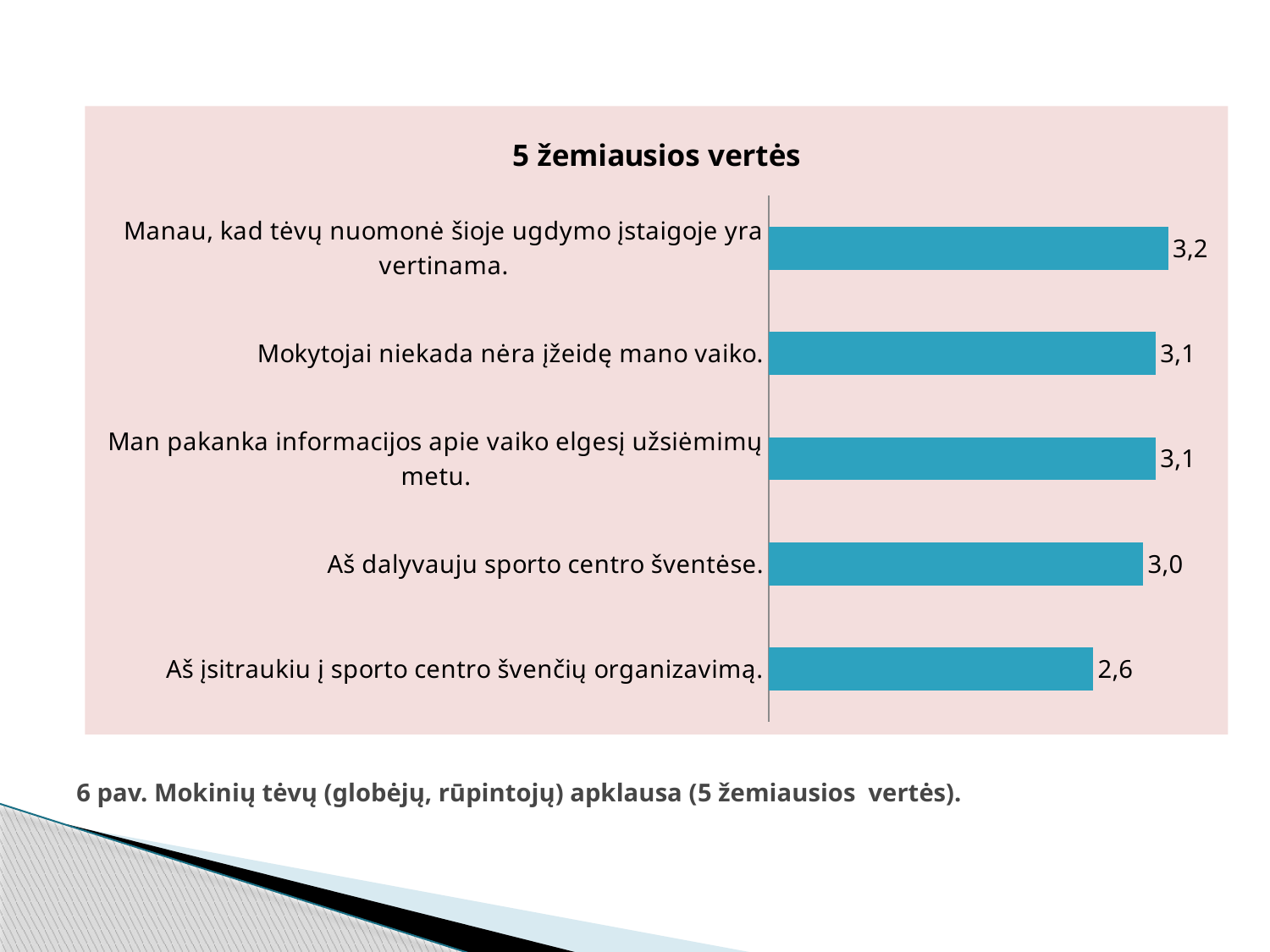
What is the value for "Aš dalyvauju sporto centro šventėse."? 3,0 Which category has the highest value? Manau, kad tėvų nuomonė šioje ugdymo įstaigoje yra vertinama. How many categories are shown in the chart? 5 Which category has the lowest value? Aš įsitraukiu į sporto centro švenčių organizavimą. What is the value for "Manau, kad tėvų nuomonė šioje ugdymo įstaigoje yra vertinama."? 3,2 What is the title of the chart? 5 žemiausios vertės What is the value for "Aš įsitraukiu į sporto centro švenčių organizavimą."? 2,6 What is the value for "Mokytojai niekada nėra įžeidę mano vaiko."? 3,1 What is the difference between the values for "Man pakanka informacijos apie vaiko elgesį užsiėmimų metu." and "Aš dalyvauju sporto centro šventėse."? 0,1 What is the difference between the values for "Manau, kad tėvų nuomonė šioje ugdymo įstaigoje yra vertinama." and "Aš įsitraukiu į sporto centro švenčių organizavimą."? 0,6 Which is larger: the value for "Aš dalyvauju sporto centro šventėse." or for "Aš įsitraukiu į sporto centro švenčių organizavimą."? Aš dalyvauju sporto centro šventėse. What kind of chart is shown on the slide? Bar chart